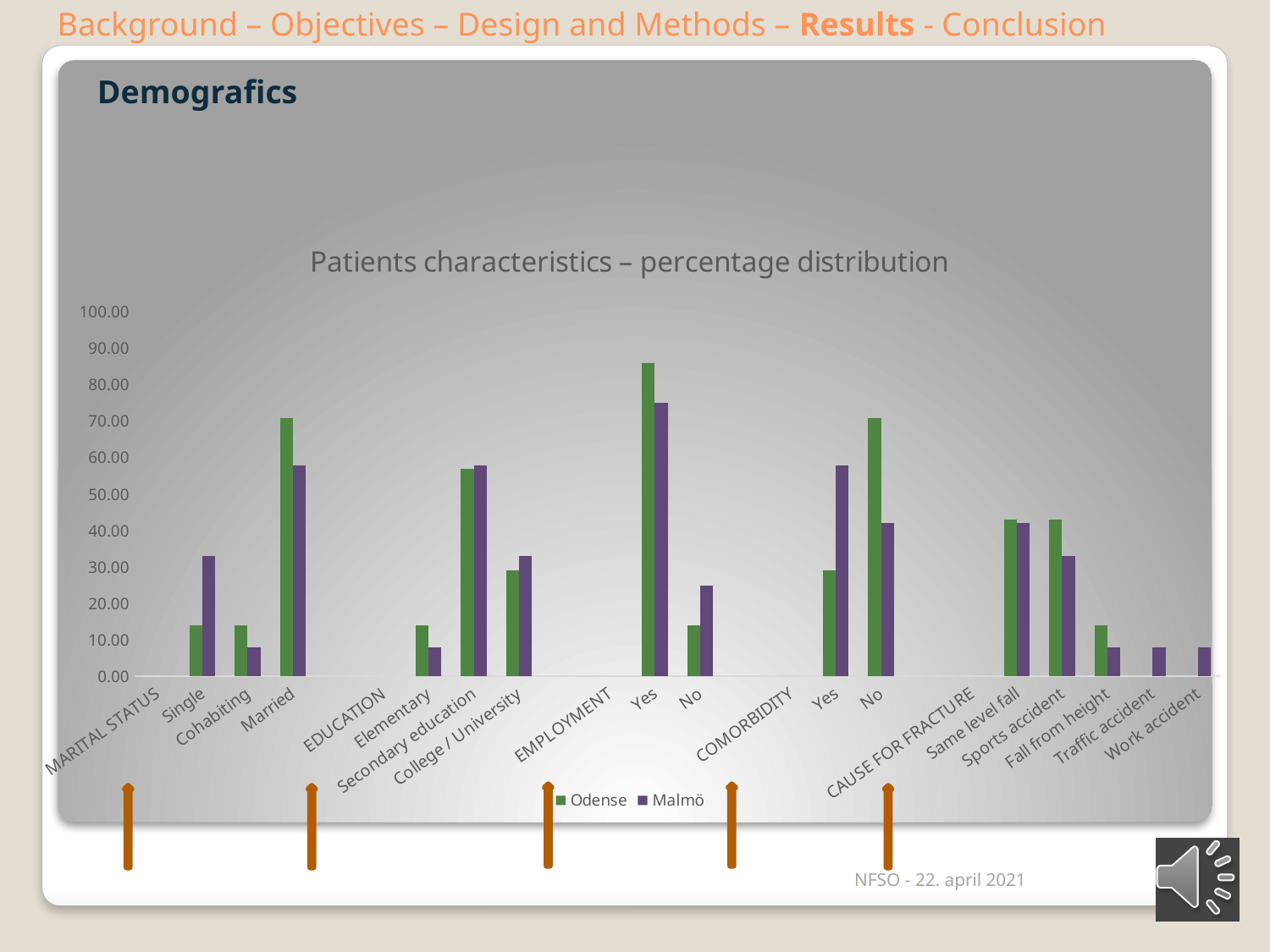
What kind of chart is shown on the slide? bar chart Is the Odense value for Comorbidity 'No' greater or less than 60.00? greater For Comorbidity 'Yes', which series has the larger value, Odense or Malmö? Malmö How many series does the legend list? 2 Is the Malmö value for Employment 'No' greater or less than 30.00? less Which category has the highest Odense bar? Employment Yes Is the Malmö value for Single greater or less than 20.00? greater For Employment 'Yes', which series has the larger value, Odense or Malmö? Odense For Sports accident, which series has the larger value, Odense or Malmö? Odense What are the two series named in the legend? Odense and Malmö What is the title of the chart? Patients characteristics – percentage distribution